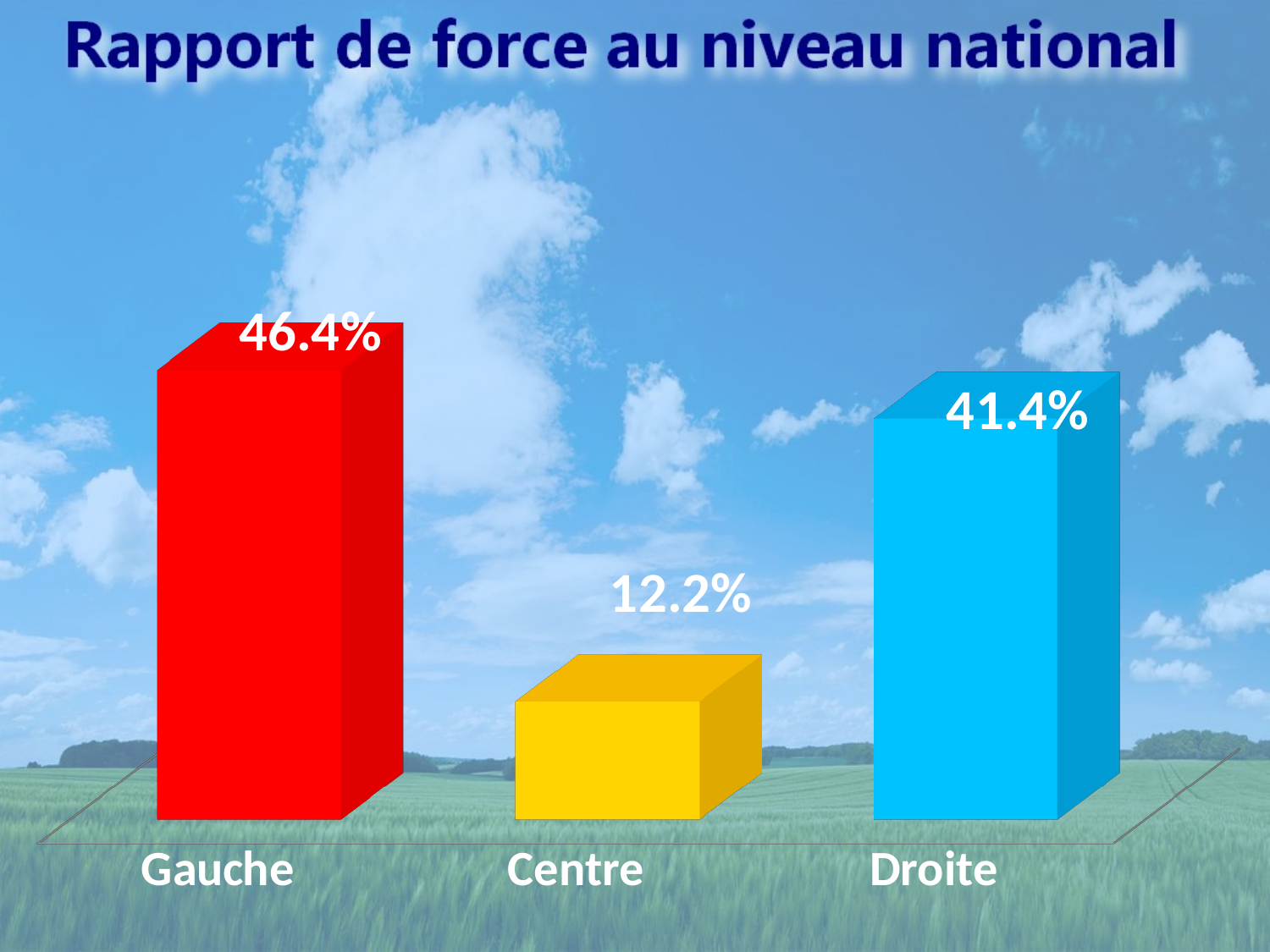
How many categories are shown in the chart? 3 What is the value for Centre? 12.2% Which is larger, the value for Gauche or the value for Droite? Gauche What is the difference between the values for Droite and Centre? 29.2% What colour is the bar for Centre? Yellow Which category has the lowest value? Centre What is the difference between the values for Gauche and Droite? 5.0% What is the value for Droite? 41.4% What is the title of the chart? Rapport de force au niveau national Which category has the highest value? Gauche What kind of chart is shown on the slide? Bar chart What is the value for Gauche? 46.4%